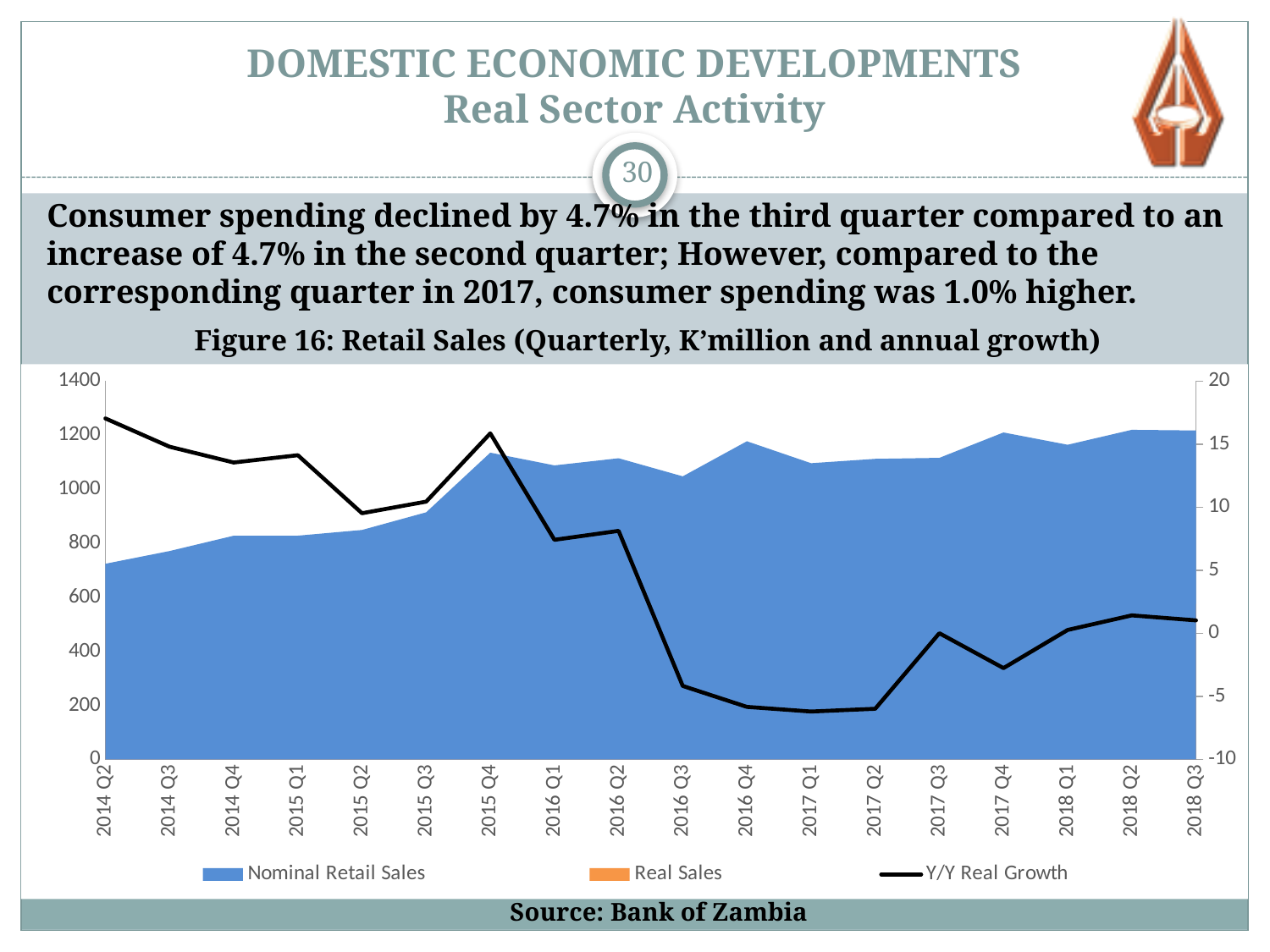
In which quarter is Y/Y Real Growth at its highest? 2014 Q2 Which series is drawn as a black line in the chart? Y/Y Real Growth In which quarter is Nominal Retail Sales at its lowest? 2014 Q2 Which quarter has the higher Y/Y Real Growth, 2016 Q2 or 2016 Q3? 2016 Q2 What is the title of the chart on the slide? Figure 16: Retail Sales (Quarterly, K'million and annual growth) Is the Y/Y Real Growth value for 2014 Q2 greater or less than 15? greater Is the Y/Y Real Growth value for 2016 Q3 greater or less than 0? less What kind of chart is shown on the slide? A combined area and line chart How many series does the chart legend list? 3 Is the Nominal Retail Sales value for 2018 Q2 greater or less than 1000? greater How many quarters are plotted along the x axis of the chart? 18